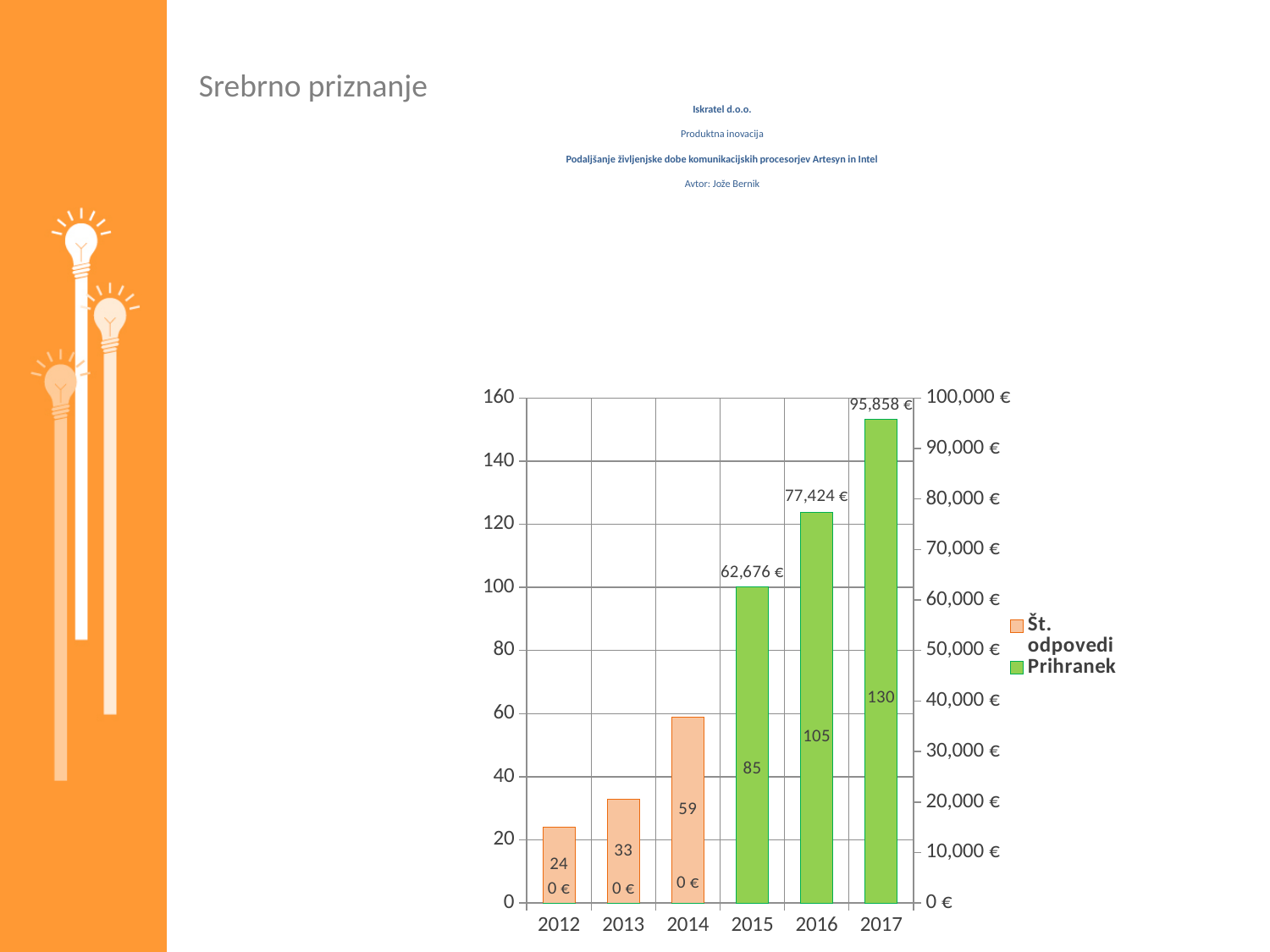
Which year has the highest Prihranek value? 2017 What is the value of Št. odpovedi for 2014? 59 What is the Prihranek value for 2013? 0 € How many years are shown on the x axis? 6 Which is larger, the Št. odpovedi value for 2013 or for 2014? 2014 What is the difference between the Prihranek values for 2017 and 2015? 33,182 € What is the difference between the Št. odpovedi values for 2017 and 2016? 25 What is the Prihranek value for 2016? 77,424 € How many series does the legend list? 2 Which year has the lowest Št. odpovedi value? 2012 Do the Št. odpovedi values rise or fall from 2012 to 2017? rise What kind of chart is shown on the slide? bar chart